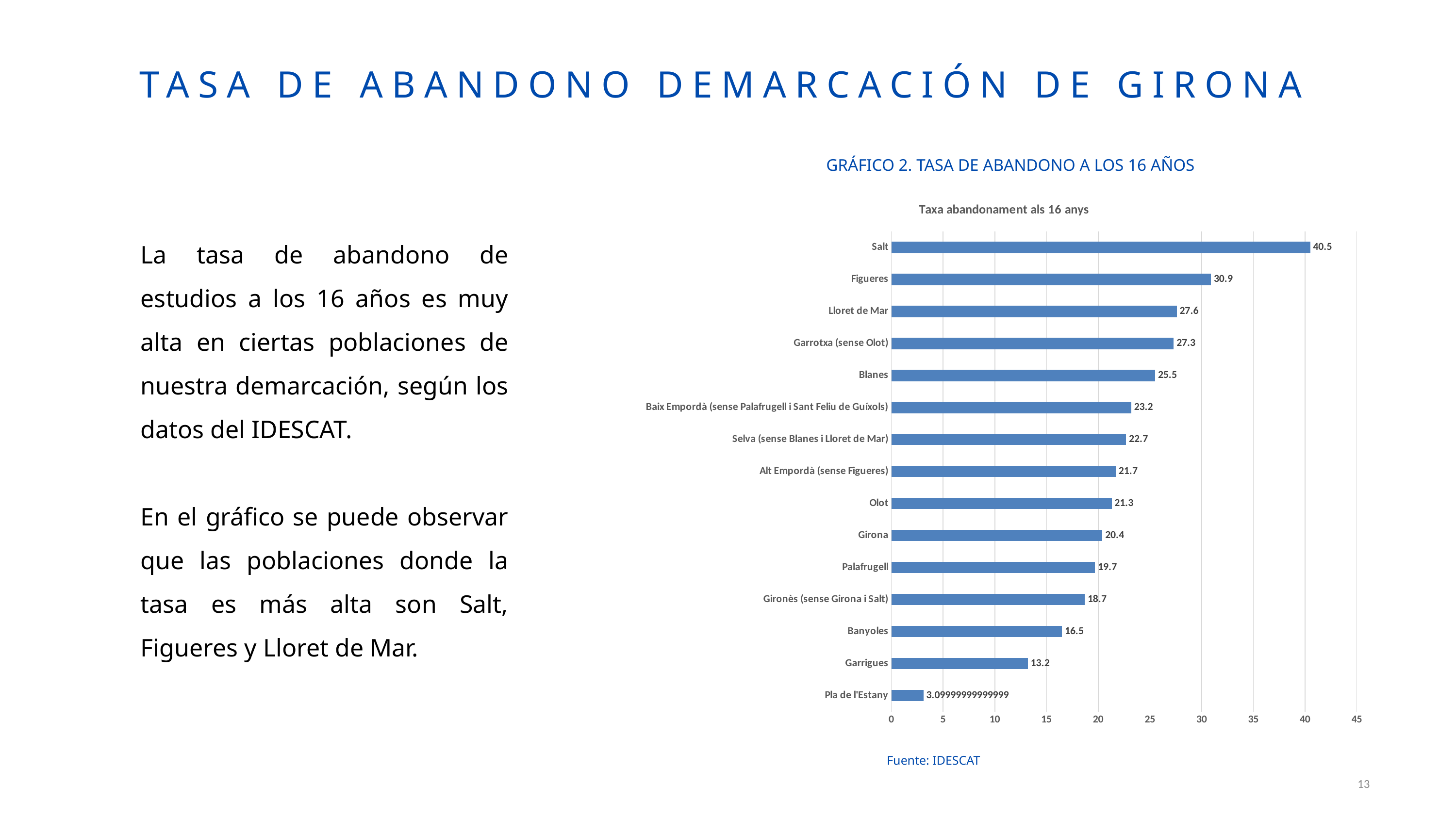
Is the value for Garrigues greater or less than 15? less What is the value for Banyoles in the chart? 16.5 What is the value for Pla de l'Estany in the chart? 3.09999999999999 What kind of chart is shown on the slide? bar chart What is the value for Lloret de Mar in the chart? 27.6 Which has a larger value, Blanes or Olot? Blanes What is the value for Salt in the chart? 40.5 Which category has the highest value in the chart? Salt What is the difference between the values for Salt and Figueres? 9.6 How many categories are shown in the chart? 15 Which category has the lowest value in the chart? Pla de l'Estany What is the difference between the values for Girona and Banyoles? 3.9